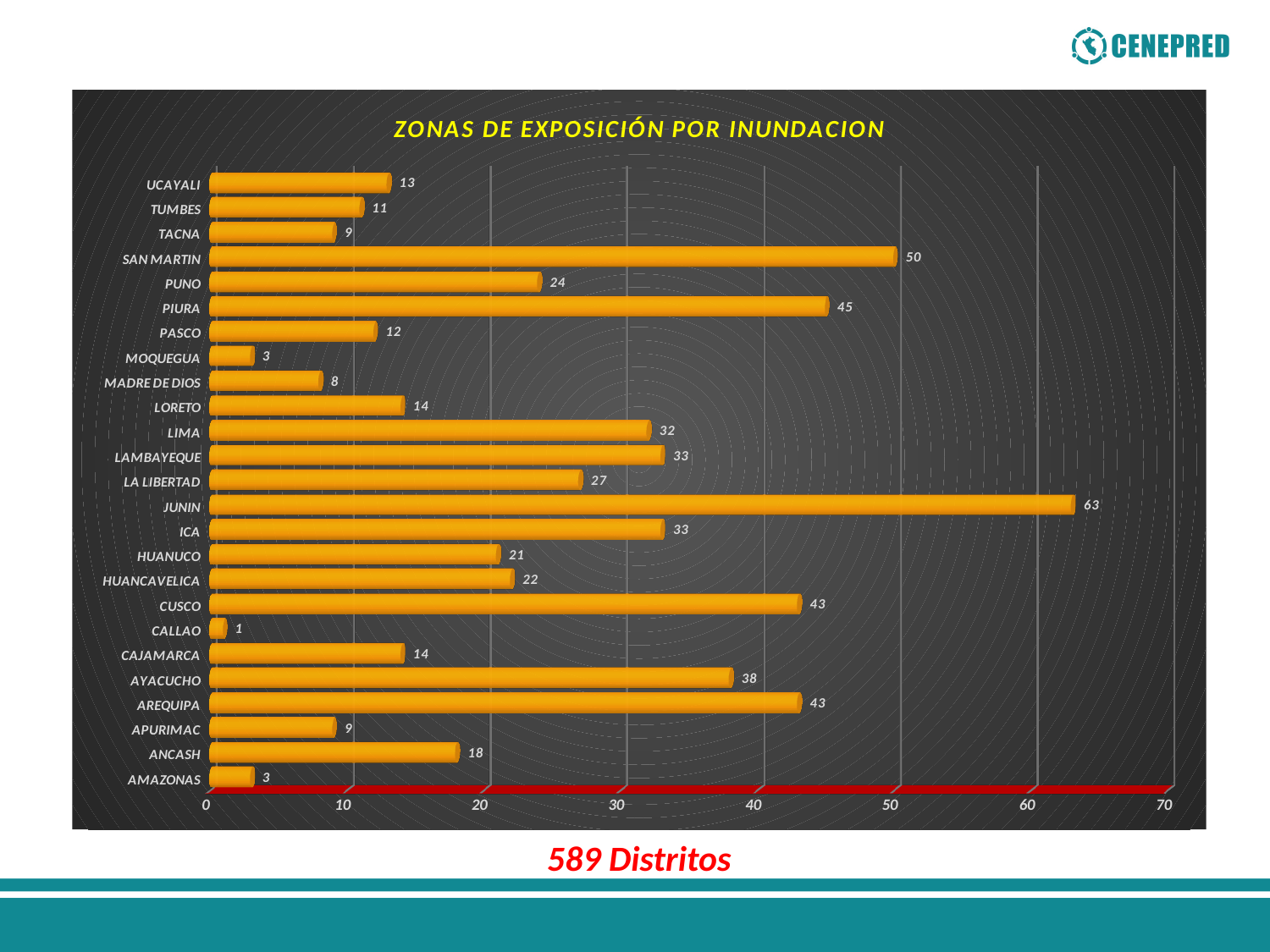
Which category has the lowest value? CALLAO How many categories are shown in the chart? 25 What is the difference between the values for PIURA and PUNO? 21 Which is larger, the value for AYACUCHO or the value for LIMA? AYACUCHO What kind of chart is shown on the slide? bar chart Is the value for CUSCO greater or less than 40? greater What is the value for SAN MARTIN? 50 What is the title of the chart? ZONAS DE EXPOSICIÓN POR INUNDACION What is the total number of districts stated below the chart? 589 Distritos Which category has the highest value? JUNIN What is the value for MADRE DE DIOS? 8 What is the value for JUNIN? 63